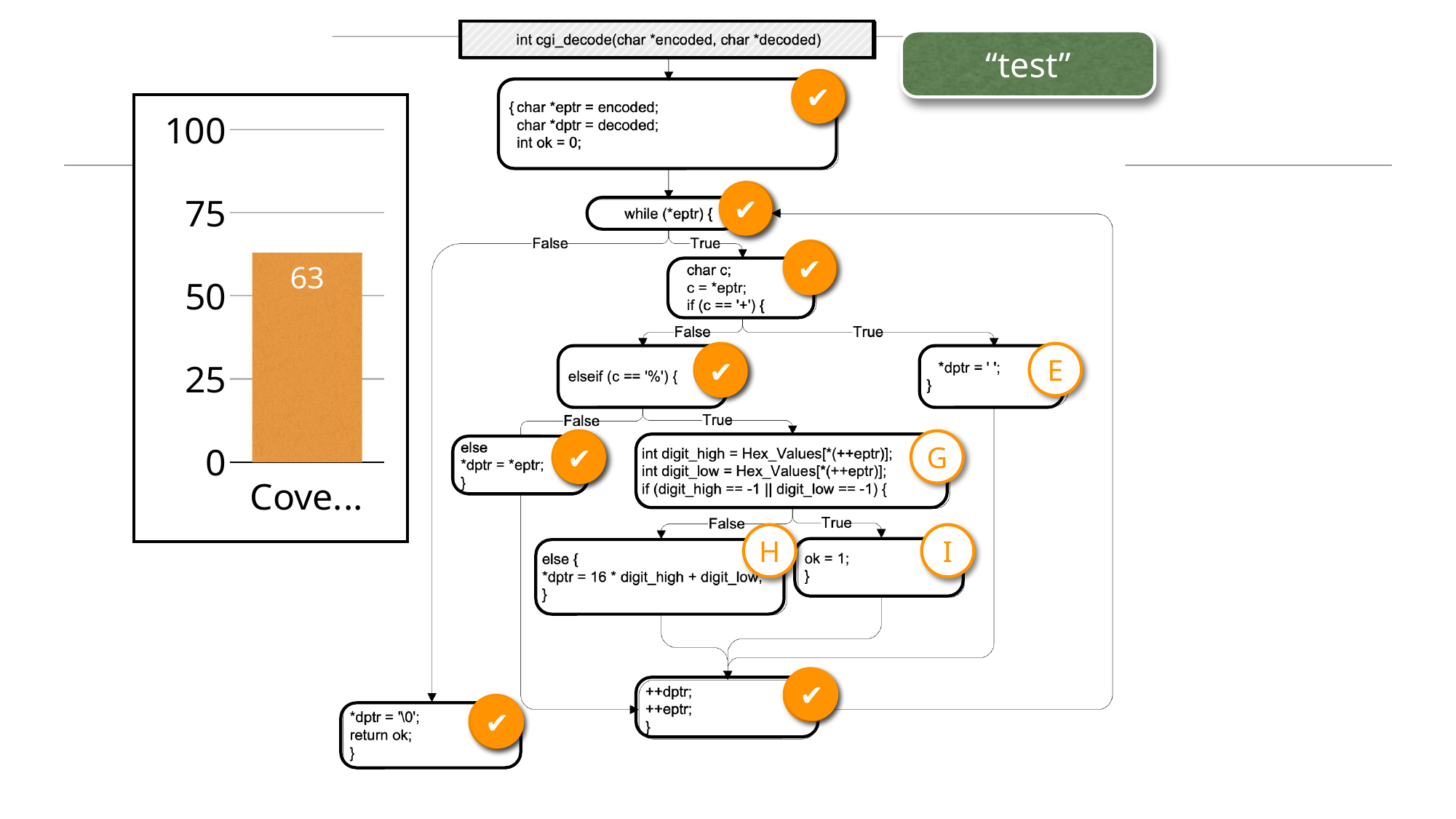
Is the value of the bar greater or less than 50? greater Is the bar's value greater or less than 25? greater Is the value of the bar greater or less than 75? less How many bars does the chart contain? 1 What is the lowest tick value shown on the chart's vertical axis? 0 What kind of chart is shown on the left of the slide? bar chart What value is printed on the bar in the bar chart? 63 What is the highest tick value shown on the chart's vertical axis? 100